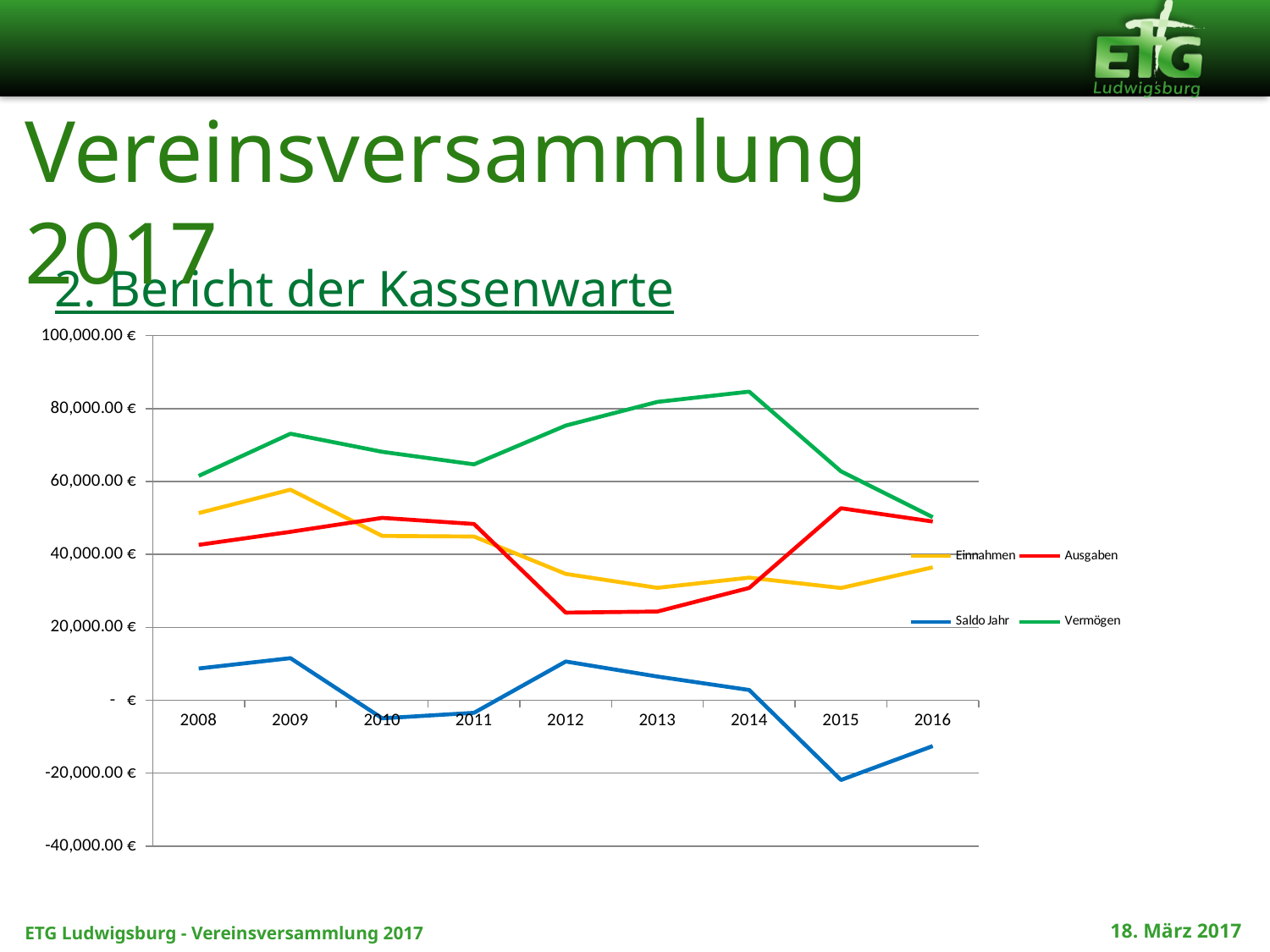
In 2015, which is larger: Einnahmen or Ausgaben? Ausgaben Does the Vermögen series rise or fall from 2014 to 2016? fall What kind of chart is shown on the slide? line chart Is the value for Saldo Jahr in 2015 greater or less than -20,000.00 €? less How many years are plotted along the x axis? 9 In which year does the Saldo Jahr series reach its lowest value? 2015 How many series does the legend list? 4 In which year does the Vermögen series reach its highest value? 2014 Is the value for Einnahmen in 2009 greater or less than 60,000.00 €? less In 2008, which is larger: Einnahmen or Ausgaben? Einnahmen In which year does the Einnahmen series reach its highest value? 2009 Is the value for Vermögen in 2014 greater or less than 80,000.00 €? greater